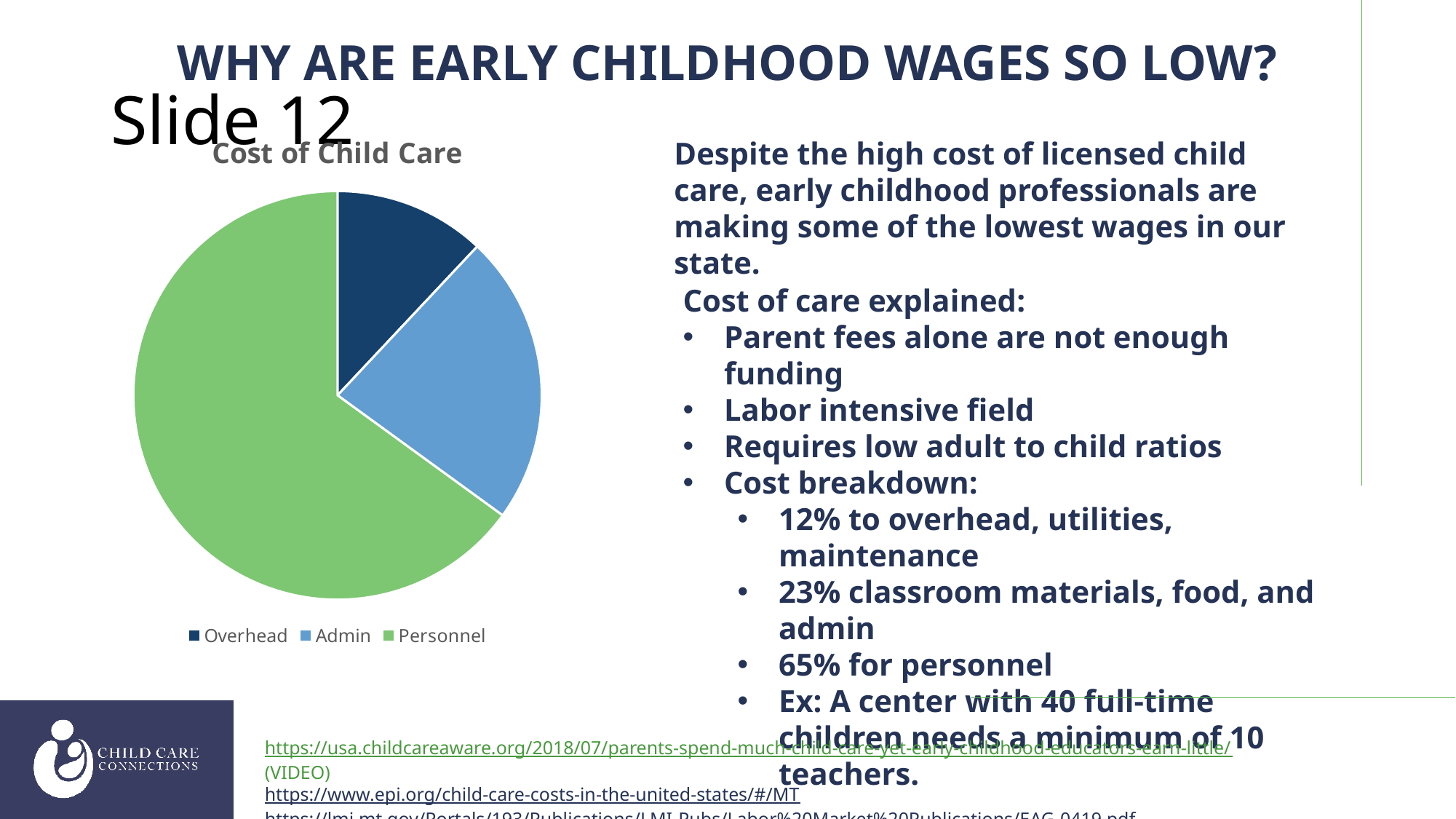
Does the Personnel slice make up more or less than half of the Cost of Child Care pie? More Which colour represents Personnel in the Cost of Child Care chart? Green What kind of chart is shown on the slide? Pie chart Which category takes the largest share of the Cost of Child Care pie chart? Personnel How many entries does the legend of the Cost of Child Care chart list? 3 Which category takes the smallest share of the Cost of Child Care pie chart? Overhead In the Cost of Child Care chart, which slice is larger: Admin or Overhead? Admin How many slices does the Cost of Child Care pie chart have? 3 In the Cost of Child Care chart, which slice is larger: Personnel or Admin? Personnel What is the title of the chart on the slide? Cost of Child Care